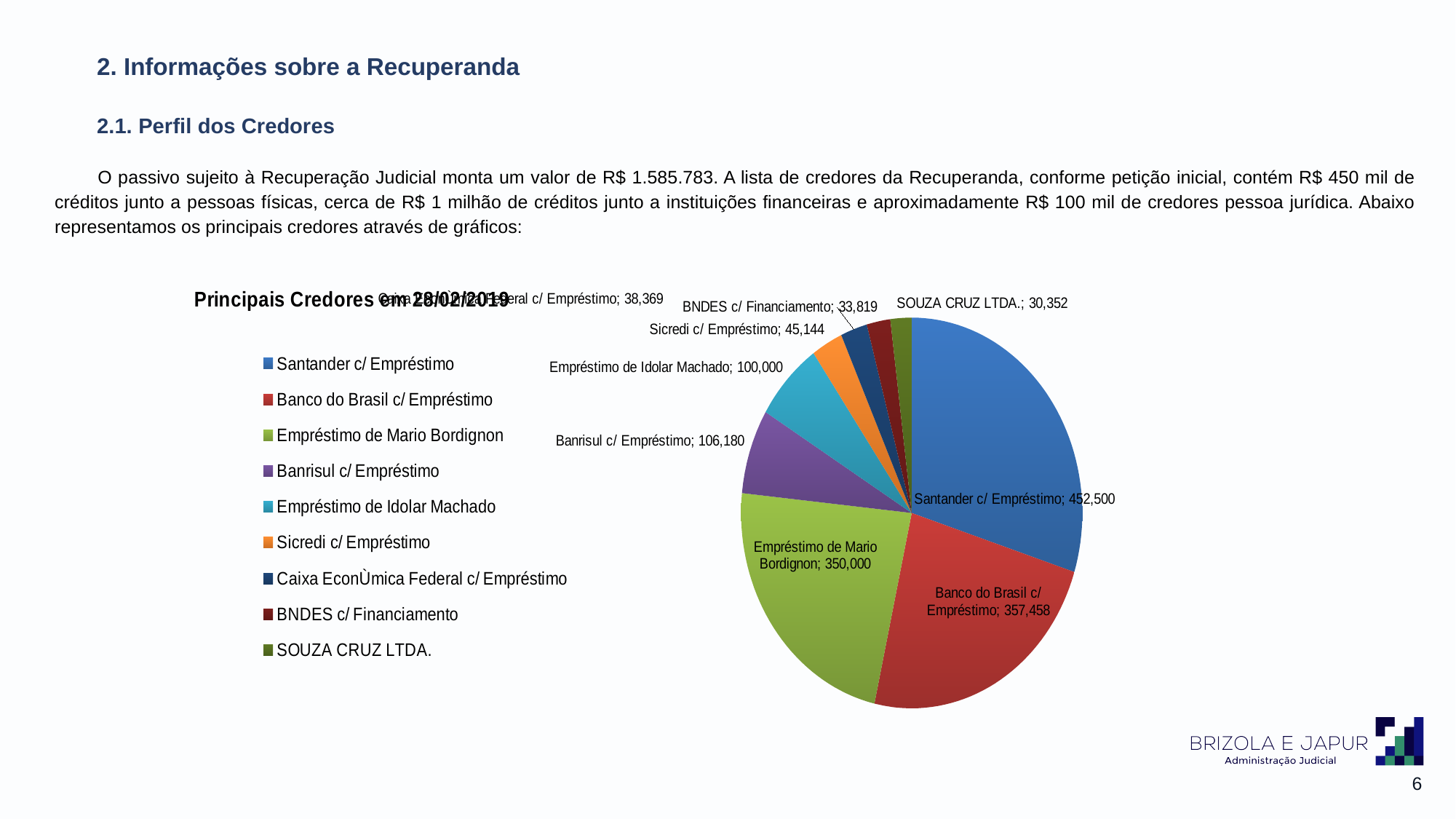
What is the value for Sicredi c/ Empréstimo? 45,144 Which creditor has the largest slice of the pie chart? Santander c/ Empréstimo What colour is the slice for Empréstimo de Mario Bordignon? green What kind of chart is shown on the slide? pie chart Which creditor has the smallest slice of the pie chart? SOUZA CRUZ LTDA. Which is larger, the value for Banrisul c/ Empréstimo or the value for Empréstimo de Idolar Machado? Banrisul c/ Empréstimo What is the value for Empréstimo de Mario Bordignon? 350,000 What is the difference between the values for Santander c/ Empréstimo and Banco do Brasil c/ Empréstimo? 95,042 What is the value for Banco do Brasil c/ Empréstimo? 357,458 What is the value for Santander c/ Empréstimo in the pie chart? 452,500 What is the value for Banrisul c/ Empréstimo? 106,180 How many creditors (slices) are shown in the pie chart? 9